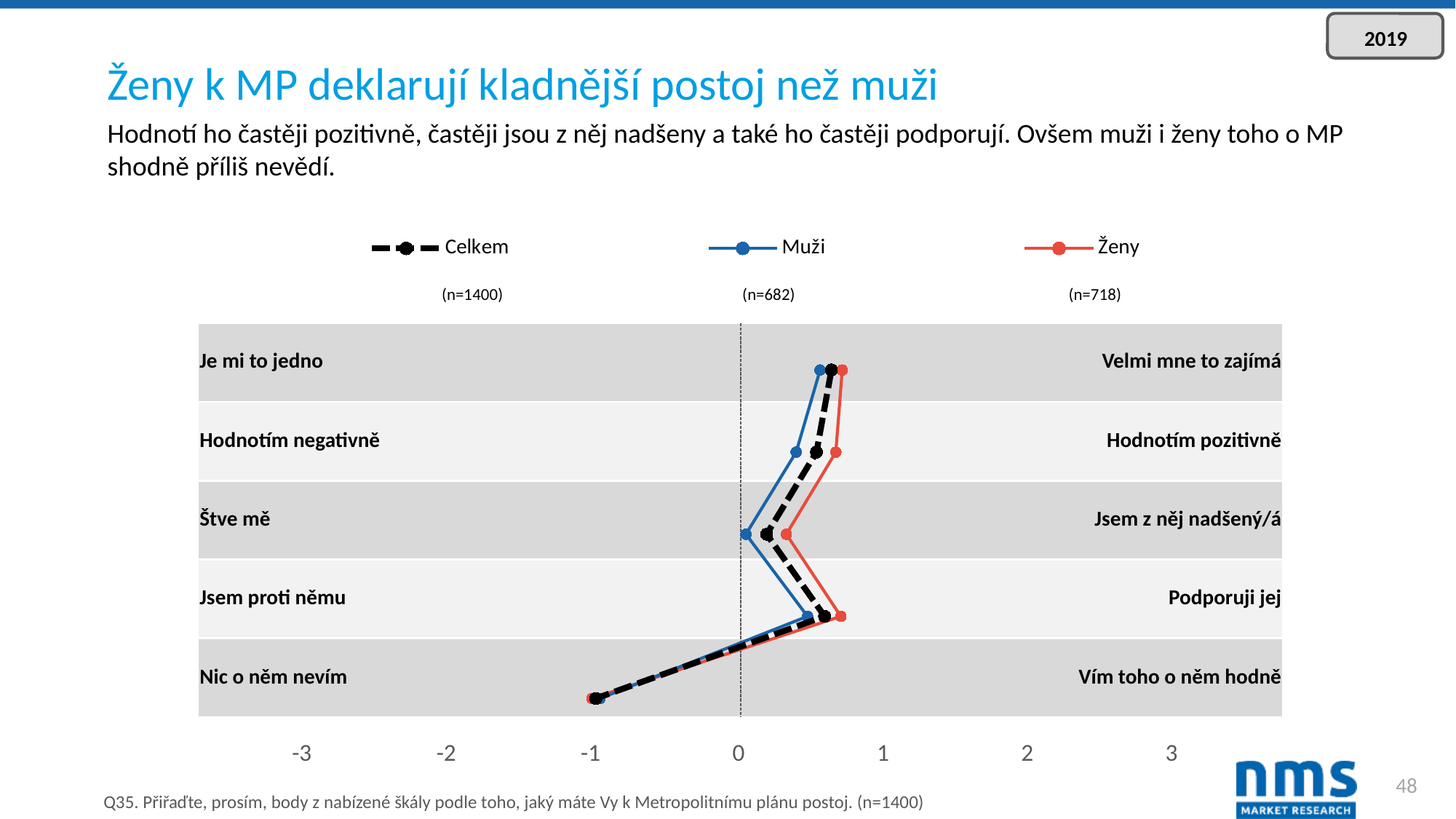
Which series has the lowest value on the 'Štve mě / Jsem z něj nadšený/á' row? Muži On the 'Štve mě / Jsem z něj nadšený/á' row, which series has the larger value, Muži or Ženy? Ženy What kind of chart is shown on the slide? line chart On which row does the Celkem series have its lowest value? Nic o něm nevím / Vím toho o něm hodně What sample size is shown under the Ženy legend entry? n=718 What colour is the Muži line in the chart? blue On the 'Hodnotím negativně / Hodnotím pozitivně' row, which series has the larger value, Muži or Ženy? Ženy Is the value for Celkem on the 'Nic o něm nevím / Vím toho o něm hodně' row greater or less than 0? less How many series does the legend list? 3 Is the value for Ženy on the 'Hodnotím negativně / Hodnotím pozitivně' row greater or less than 0? greater Is the value for Muži on the 'Je mi to jedno / Velmi mne to zajímá' row greater or less than 1? less How many statement pairs (rows) are plotted on the chart? 5